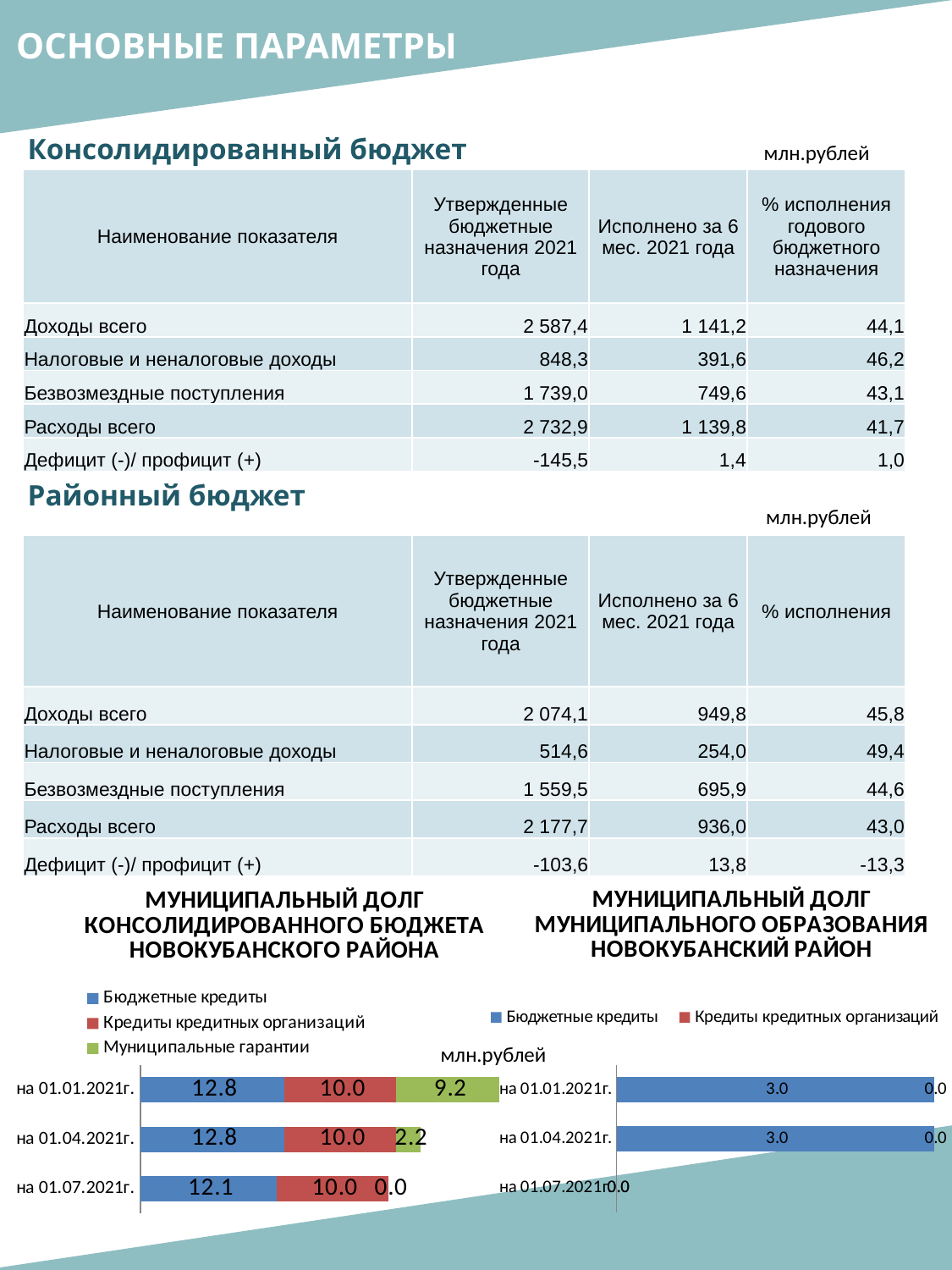
In the left chart (консолидированный бюджет), what is the value of 'Кредиты кредитных организаций' for 'на 01.04.2021г.'? 10.0 In the left chart (консолидированный бюджет), what is the total municipal debt for 'на 01.01.2021г.'? 32.0 In the left chart (консолидированный бюджет), what is the value of 'Муниципальные гарантии' for 'на 01.01.2021г.'? 9.2 In the right chart (муниципальное образование Новокубанский район), how many series does the legend list? 2 In the left chart (консолидированный бюджет), by how much did 'Муниципальные гарантии' decrease from 'на 01.01.2021г.' to 'на 01.04.2021г.'? 7.0 In the left chart (консолидированный бюджет), which date has the largest total municipal debt? на 01.01.2021г. What kind of chart is the left chart titled 'МУНИЦИПАЛЬНЫЙ ДОЛГ КОНСОЛИДИРОВАННОГО БЮДЖЕТА НОВОКУБАНСКОГО РАЙОНА'? Stacked bar chart In the left chart (консолидированный бюджет), what is the value of 'Бюджетные кредиты' for 'на 01.07.2021г.'? 12.1 In the right chart (муниципальное образование Новокубанский район), what is the value of 'Бюджетные кредиты' for 'на 01.04.2021г.'? 3.0 In the left chart (консолидированный бюджет), how many series does the legend list? 3 In the right chart (муниципальное образование Новокубанский район), what is the value of 'Кредиты кредитных организаций' for 'на 01.01.2021г.'? 0.0 In the left chart (консолидированный бюджет), what is the total municipal debt for 'на 01.04.2021г.'? 25.0